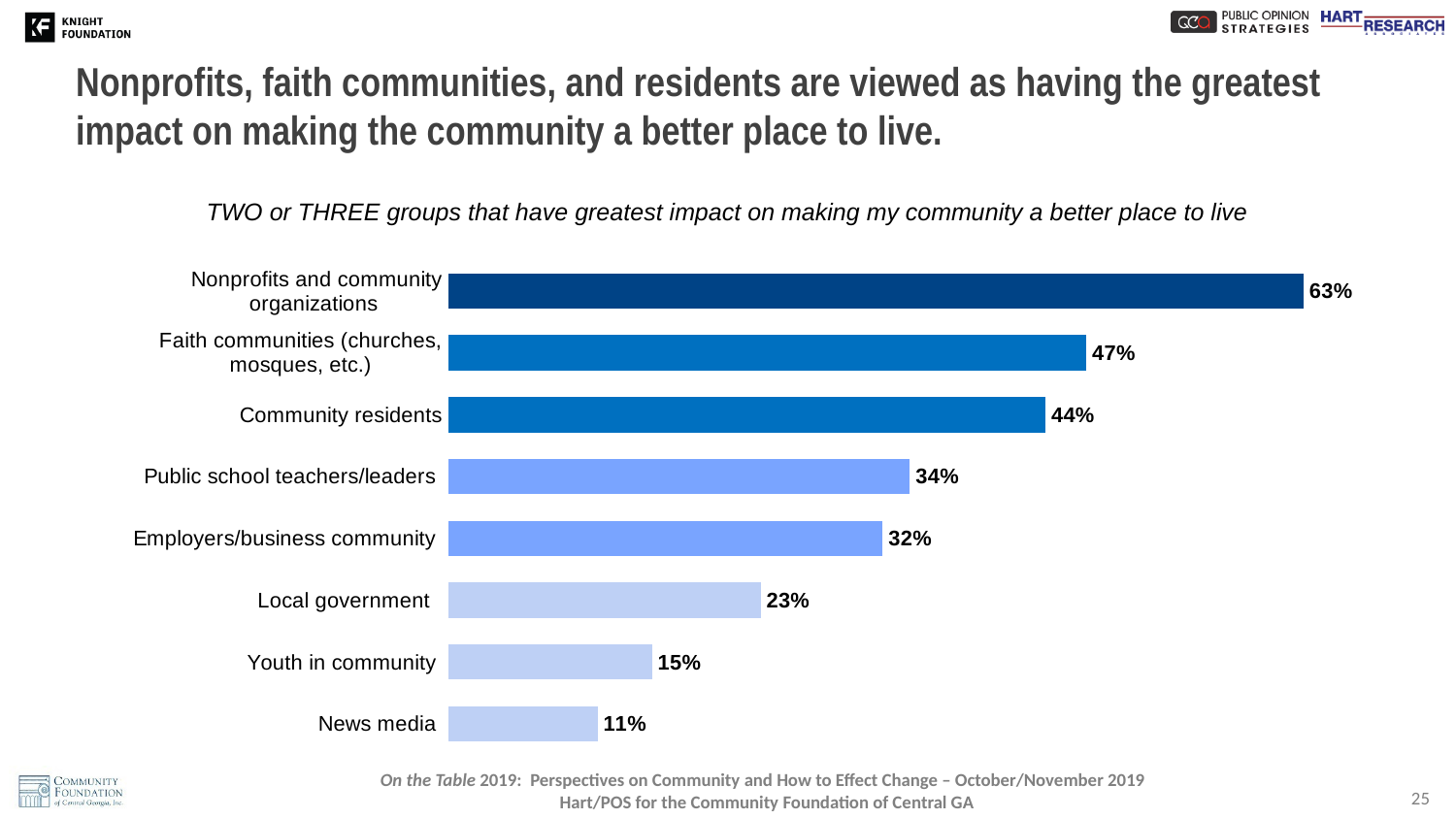
What is the difference between the values for Nonprofits and community organizations and News media? 52 percentage points What is the subtitle shown above the chart? TWO or THREE groups that have greatest impact on making my community a better place to live What percentage of respondents named nonprofits and community organizations as having the greatest impact? 63% What is the difference between the values for Faith communities and Community residents? 3 percentage points How many groups are shown in the chart? 8 Which has a higher value: Public school teachers/leaders or Employers/business community? Public school teachers/leaders Which has a higher value: Local government or Youth in community? Local government What type of chart is shown on the slide? Bar chart What is the value shown for Youth in community? 15% Which group has the highest value in the chart? Nonprofits and community organizations Which group has the lowest value in the chart? News media What is the value shown for Local government? 23%